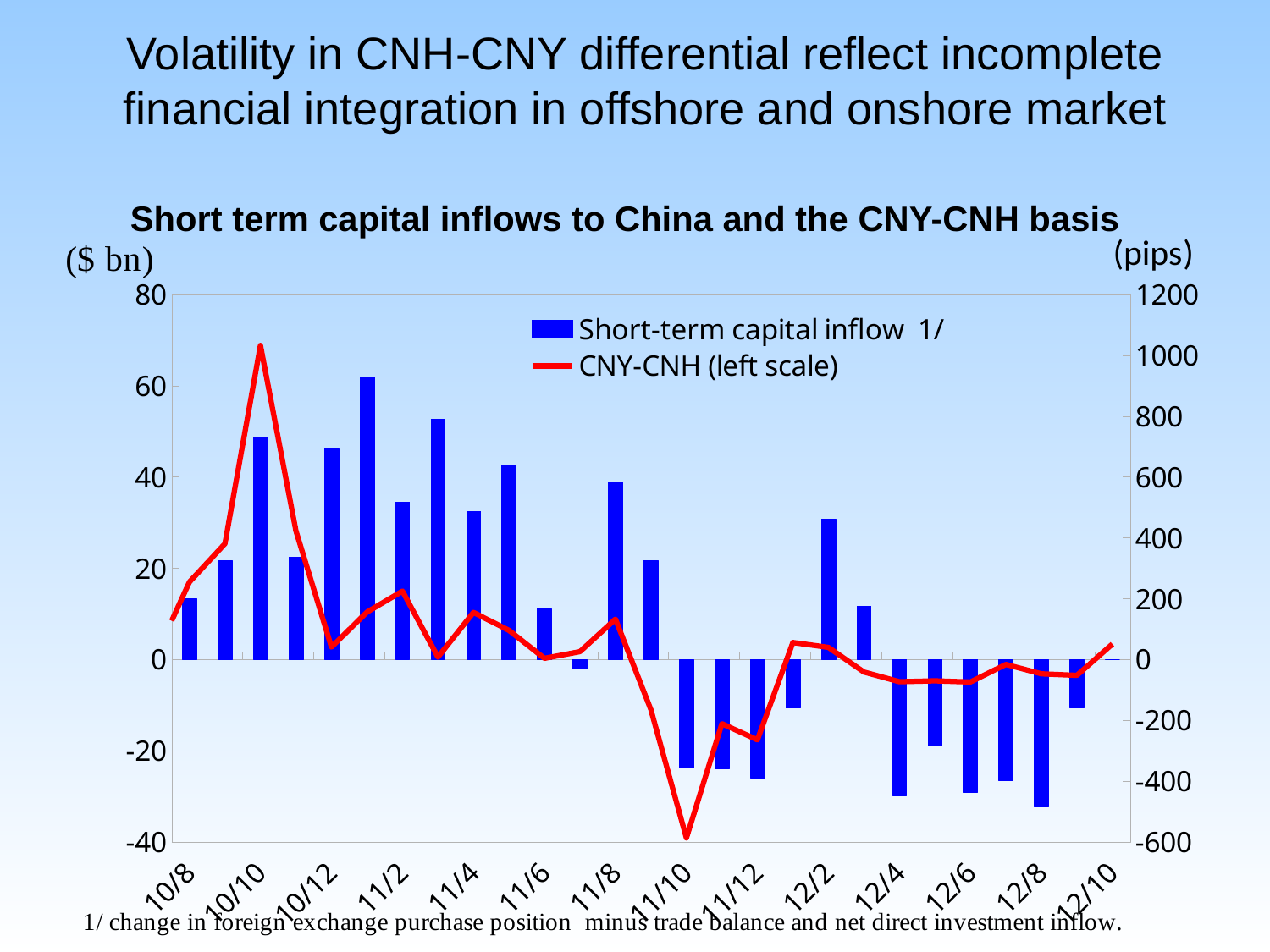
At which labeled month does the CNY-CNH line reach its highest value? 10/10 Do the short-term capital inflow bars generally rise or fall from 10/8 to 12/10? fall What is the title of the chart? Short term capital inflows to China and the CNY-CNH basis Is the short-term capital inflow bar for 11/10 greater or less than -20? less Which series is drawn as a red line? CNY-CNH (left scale) Which has the larger short-term capital inflow bar, 10/8 or 10/10? 10/10 How many series does the legend list? 2 At which labeled month does the CNY-CNH line reach its lowest value? 11/10 What kind of chart is shown on the slide? Combined bar and line chart Is the short-term capital inflow bar for 10/8 greater or less than 20? less Is the short-term capital inflow bar for 10/10 greater or less than 40? greater How many month labels are shown on the x axis? 14